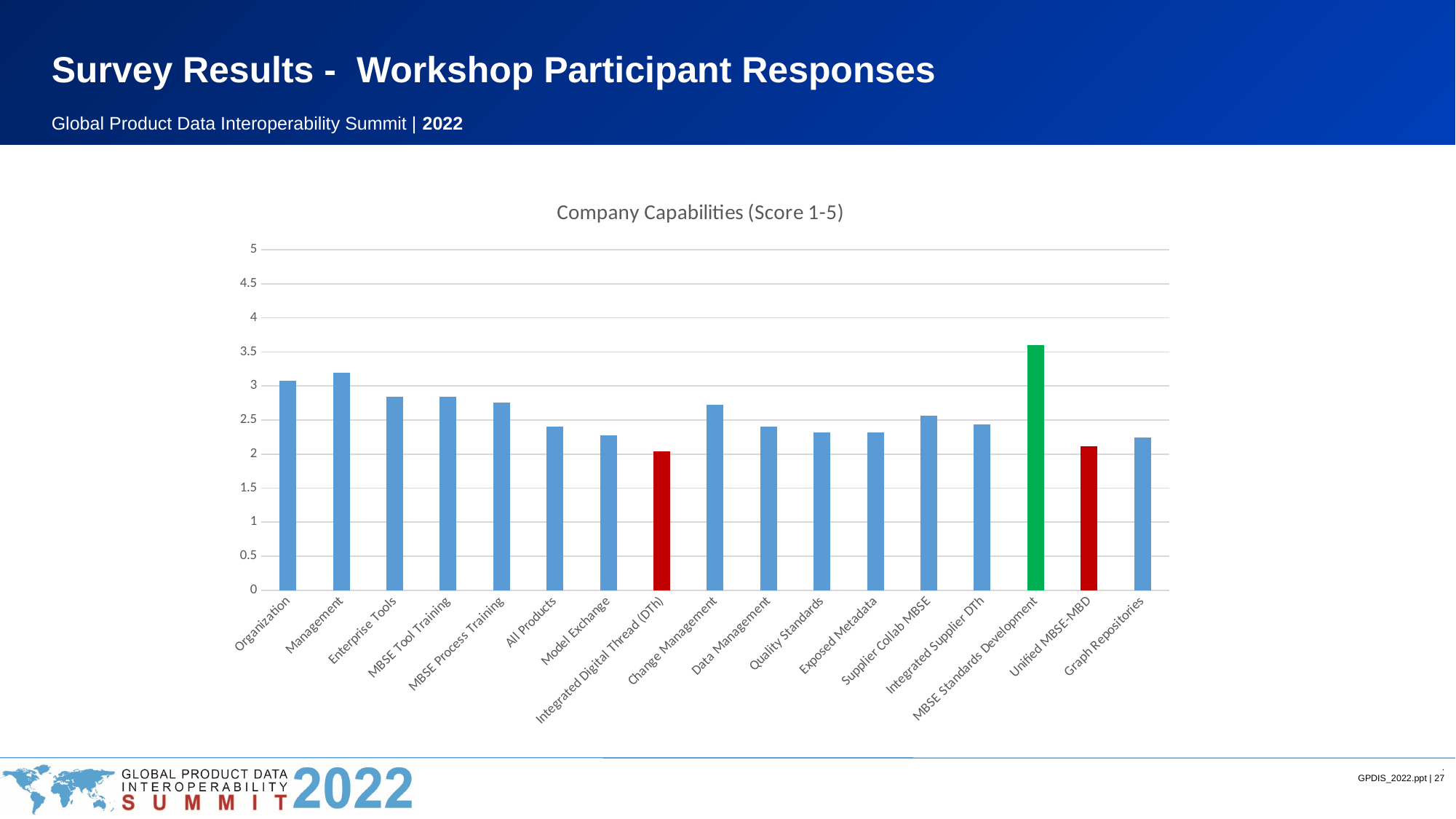
Which has the larger value, Management or Enterprise Tools? Management Is the value for Model Exchange greater or less than 2.5? less What is the title of the chart? Company Capabilities (Score 1-5) Which has the larger value, MBSE Standards Development or Unified MBSE-MBD? MBSE Standards Development Is the value for Graph Repositories greater or less than 2.5? less Is the value for Management greater or less than 3? greater How many categories are plotted on the x axis of the chart? 17 What type of chart is shown on the slide? Bar chart Which two categories are shown with red bars? Integrated Digital Thread (DTh) and Unified MBSE-MBD Which category has the highest score in the chart? MBSE Standards Development